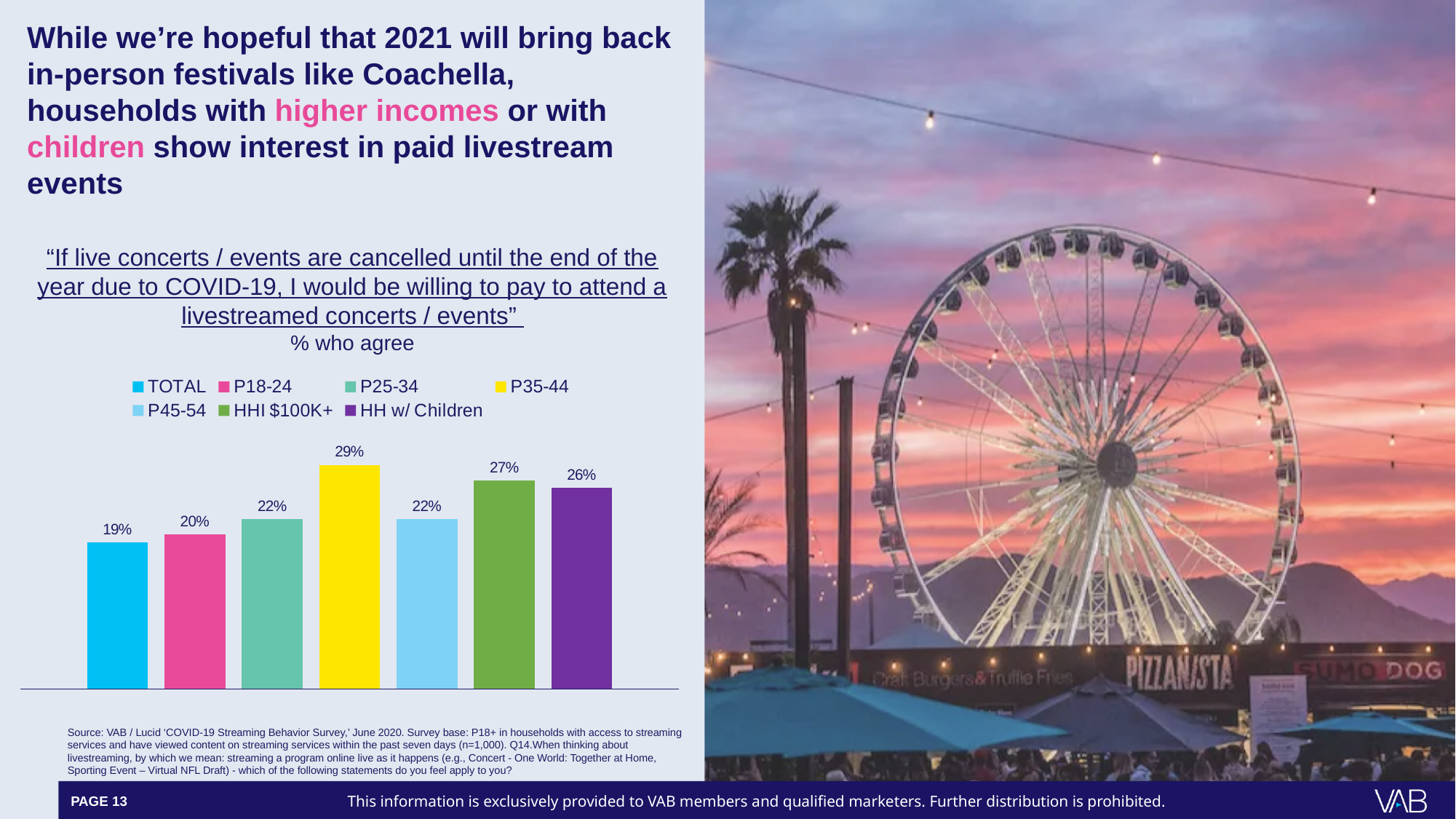
What is the value for P35-44 in the chart? 29% What type of chart is shown on the slide? Bar chart Which group has the highest percentage who agree? P35-44 What is the value for HHI $100K+ in the chart? 27% What is the difference between the P35-44 value and the TOTAL value? 10% How many bars are plotted in the chart? 7 Which group has the lowest percentage who agree? TOTAL How many entries does the chart legend list? 7 What colour is the bar for P35-44? Yellow Which is larger, the value for HHI $100K+ or the value for P18-24? HHI $100K+ What percentage of the TOTAL group agree they would be willing to pay to attend livestreamed concerts / events? 19% What is the value for HH w/ Children in the chart? 26%